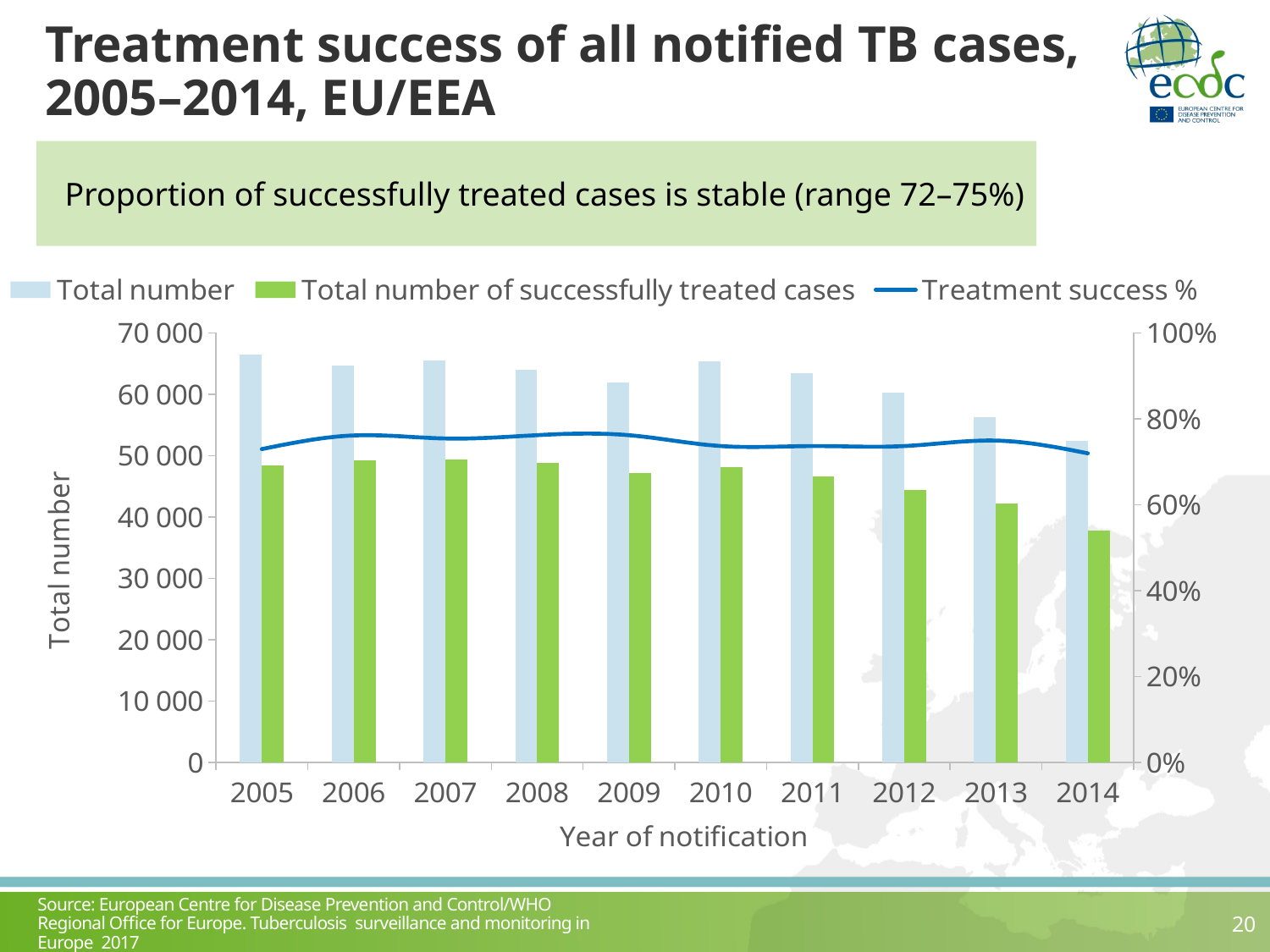
What kind of chart is shown on the slide? A combined bar and line chart Does the Total number generally rise or fall from 2005 to 2014? fall Is the Total number of successfully treated cases for 2014 greater or less than 40 000? less Which is larger, the Total number for 2012 or for 2013? 2012 What is the title of the x axis? Year of notification How many series does the legend list? 3 Is the Treatment success % for 2010 greater or less than 60%? greater Which year has the lowest Total number of successfully treated cases? 2014 Which year has the lowest Total number? 2014 Is the Total number for 2013 greater or less than 60 000? less How many years of notification are shown on the x axis? 10